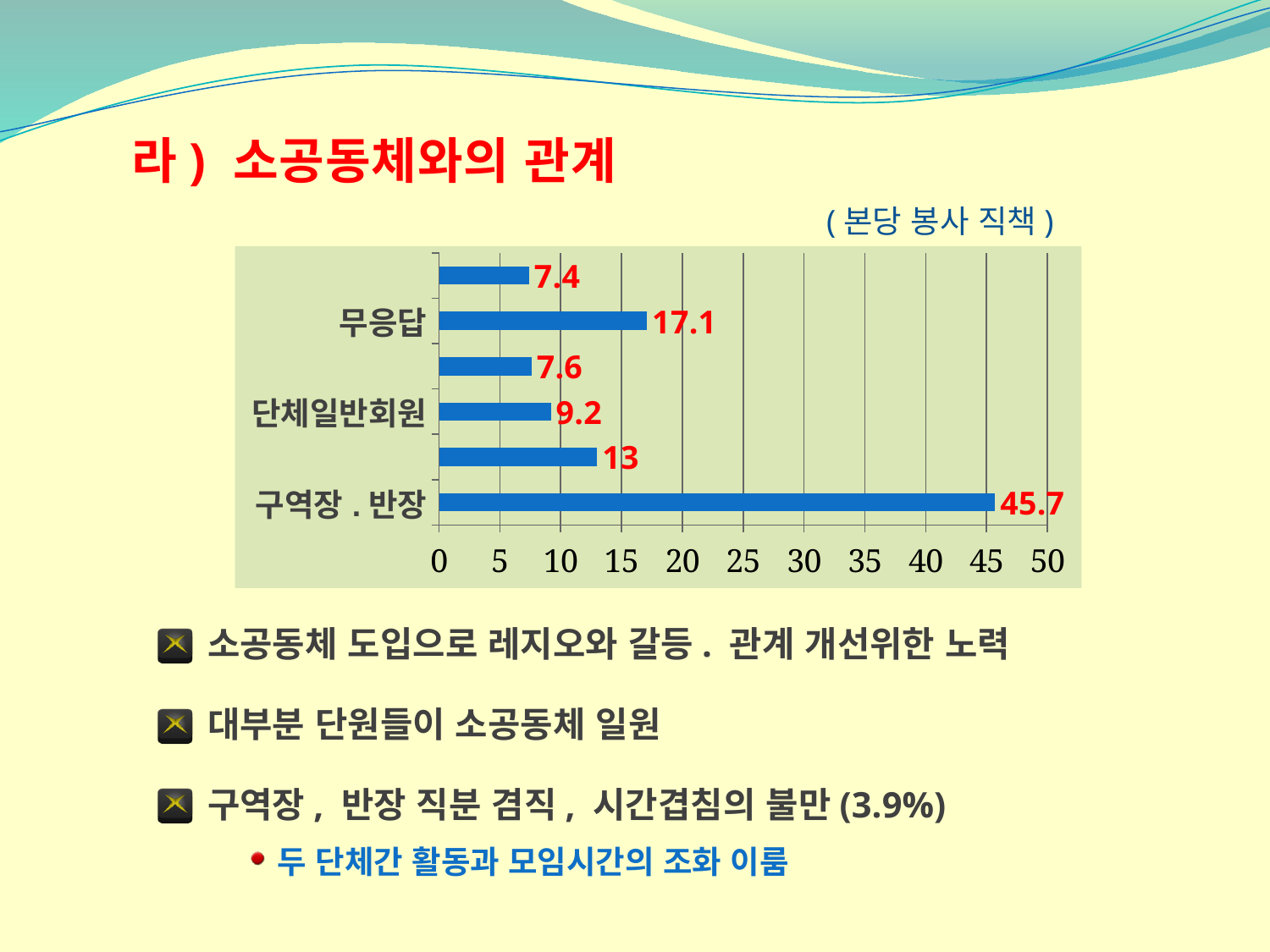
What is the value for 구역장 . 반장? 45.7 Is the value for 구역장 . 반장 greater or less than 40? greater Which is larger, the value for 무응답 or the value for 단체일반회원? 무응답 What kind of chart is shown on the slide? bar chart What is the difference between the values for 구역장 . 반장 and 무응답? 28.6 How many bars are plotted on the chart? 6 What is the value for 무응답? 17.1 What is the smallest data label shown on the chart? 7.4 What is the difference between the values for 무응답 and 단체일반회원? 7.9 Which category has the highest value? 구역장 . 반장 What is the caption shown above the chart? ( 본당 봉사 직책 ) What is the value for 단체일반회원? 9.2